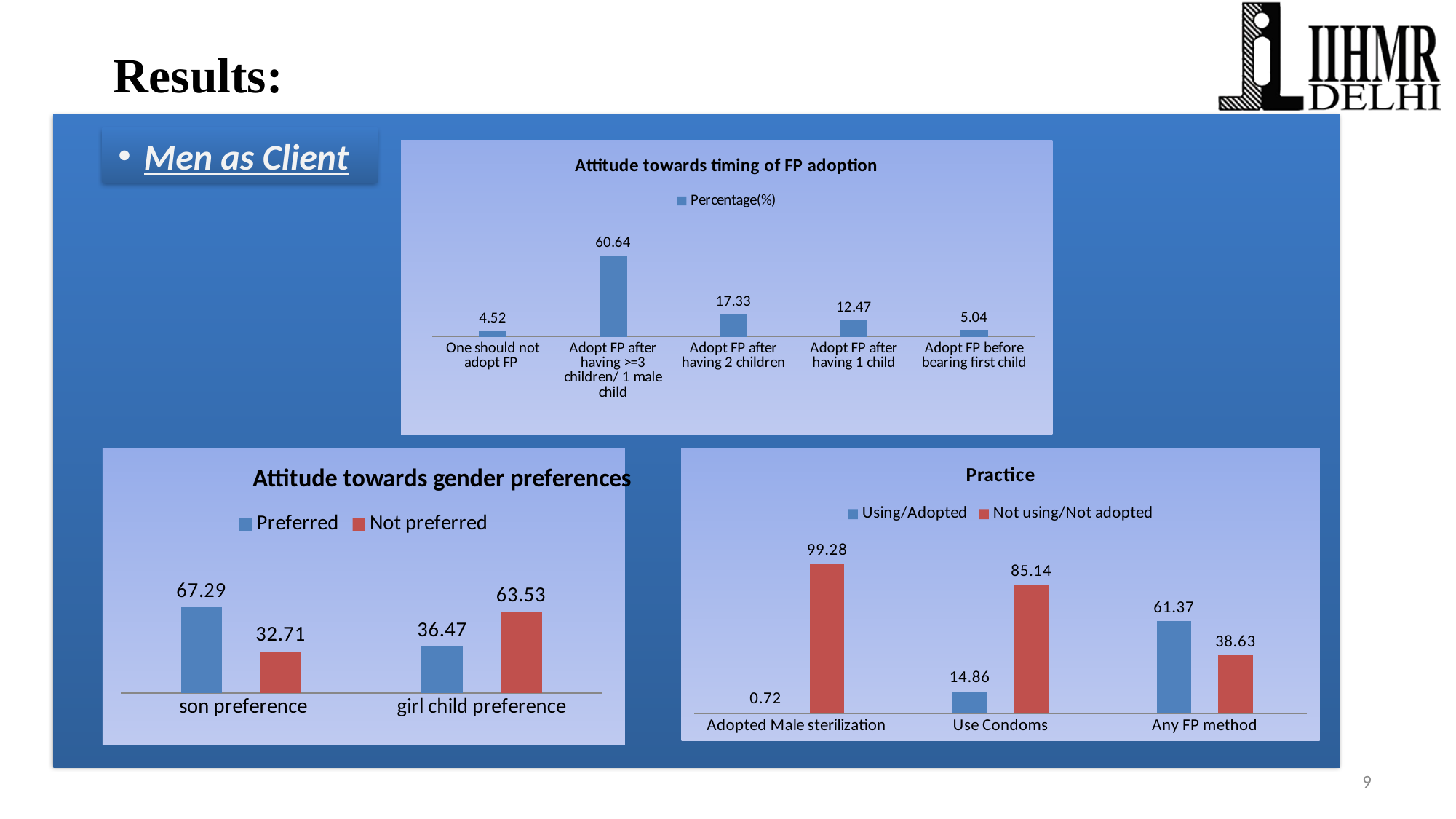
In the 'Attitude towards gender preferences' chart, how many series does the legend list? 2 In the 'Practice' chart, what is the 'Using/Adopted' value for 'Adopted Male sterilization'? 0.72 In the 'Practice' chart, which category has the highest 'Not using/Not adopted' value? Adopted Male sterilization In the 'Practice' chart, what is the difference between 'Using/Adopted' and 'Not using/Not adopted' for 'Any FP method'? 22.74 In the 'Attitude towards timing of FP adoption' chart, what is the difference between the values for 'Adopt FP after having 1 child' and 'Adopt FP before bearing first child'? 7.43 In the 'Attitude towards timing of FP adoption' chart, how many categories are shown on the x axis? 5 In the 'Attitude towards gender preferences' chart, what is the 'Not preferred' value for 'girl child preference'? 63.53 In the 'Attitude towards gender preferences' chart, which is larger for 'son preference': 'Preferred' or 'Not preferred'? Preferred In the 'Attitude towards timing of FP adoption' chart, which category has the lowest percentage? One should not adopt FP What kind of chart is the 'Practice' chart? Bar chart In the 'Attitude towards timing of FP adoption' chart, which category has the highest percentage? Adopt FP after having >=3 children/ 1 male child In the 'Attitude towards timing of FP adoption' chart, what is the percentage for 'Adopt FP after having 2 children'? 17.33